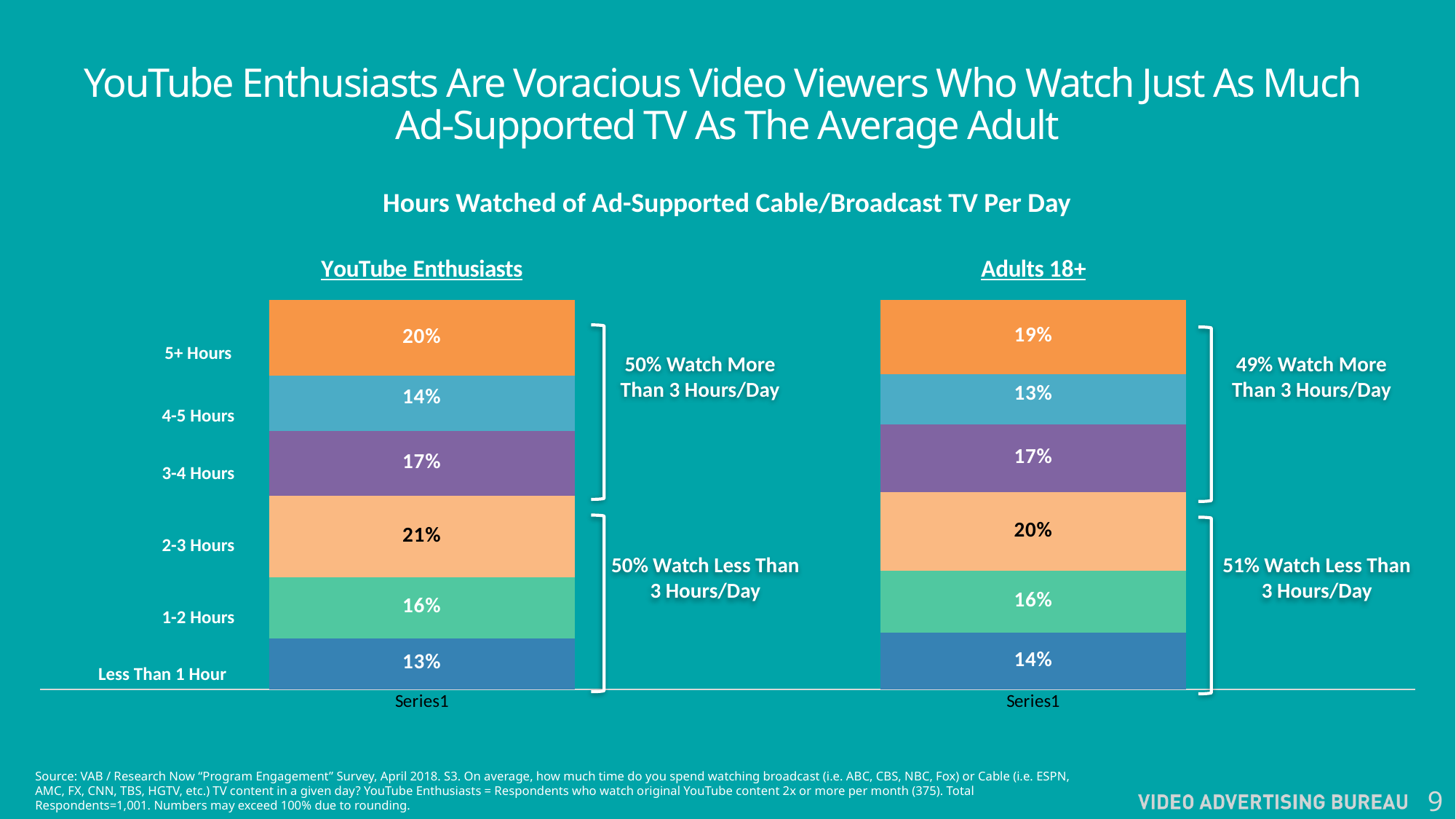
In the Adults 18+ chart, what percentage watch less than 1 hour per day? 14% In the YouTube Enthusiasts chart, what percentage watch 2-3 hours per day? 21% What type of chart is used on this slide? Stacked bar chart Which group has a larger share watching 2-3 hours per day, YouTube Enthusiasts or Adults 18+? YouTube Enthusiasts What is the title shown above the two charts? Hours Watched of Ad-Supported Cable/Broadcast TV Per Day In the YouTube Enthusiasts chart, which hours category has the smallest share? Less Than 1 Hour In the Adults 18+ chart, what percentage watch 4-5 hours per day? 13% How many hours categories are shown in each stacked bar? 6 In the Adults 18+ chart, which hours category has the smallest share? 4-5 Hours In the YouTube Enthusiasts chart, what percentage watch 5+ hours of ad-supported TV per day? 20% In the YouTube Enthusiasts chart, which hours category has the largest share? 2-3 Hours What is the difference between the 5+ Hours share for YouTube Enthusiasts and for Adults 18+? 1 percentage point